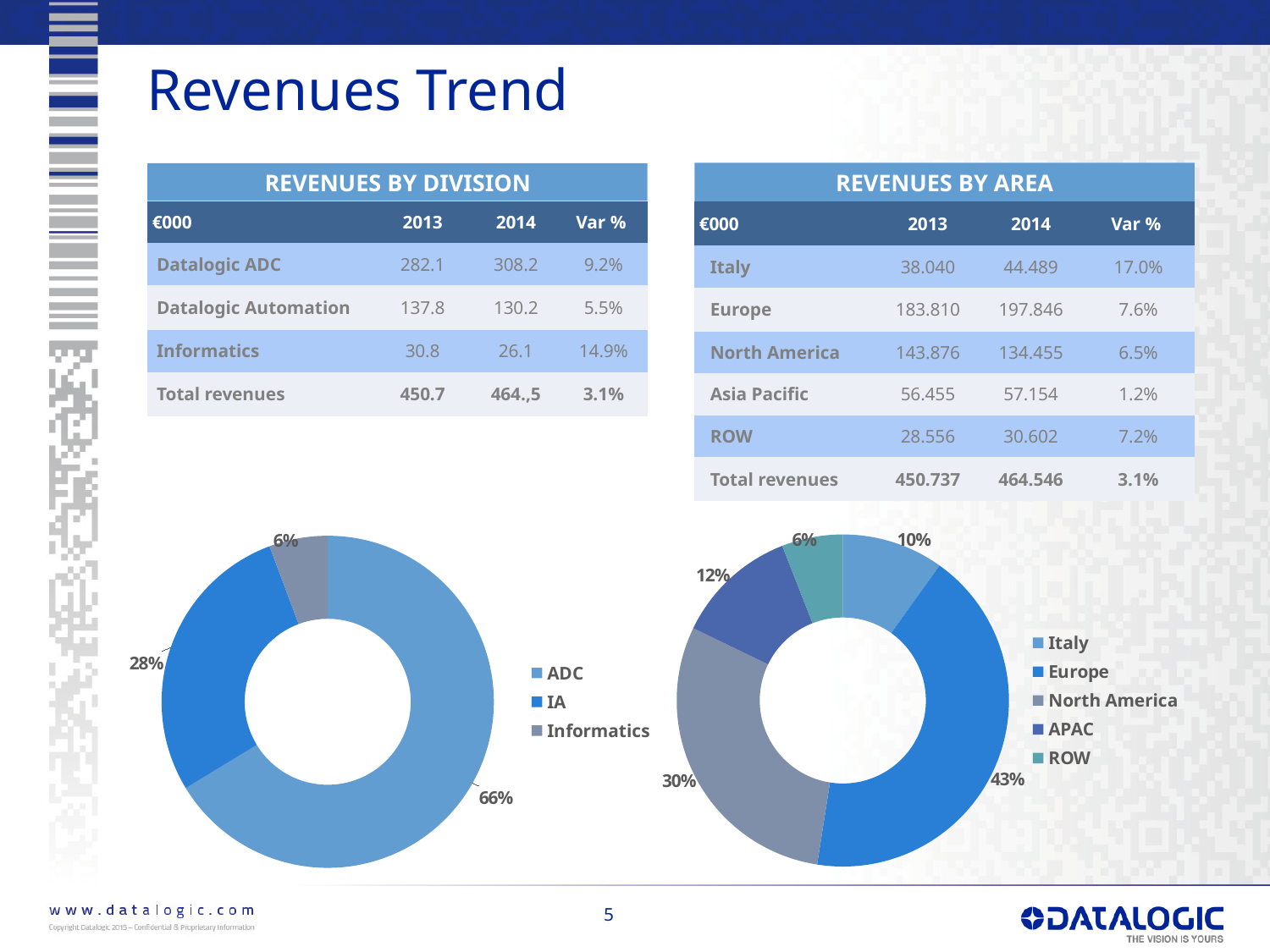
In the right doughnut chart, what share does North America have? 30% In the left doughnut chart, how many segments are there? 3 In the right doughnut chart, which segment is the largest? Europe What type of chart is used on the left side of the slide? Doughnut chart In the left doughnut chart, which segment is the smallest? Informatics In the left doughnut chart, what share does IA have? 28% In the right doughnut chart, what share does Europe have? 43% How many entries does the legend of the right doughnut chart list? 5 In the right doughnut chart, what share does APAC have? 12% In the right doughnut chart, which is larger, Italy or APAC? APAC In the left doughnut chart, what share does ADC have? 66% In the left doughnut chart, what is the difference in percentage points between ADC and IA? 38